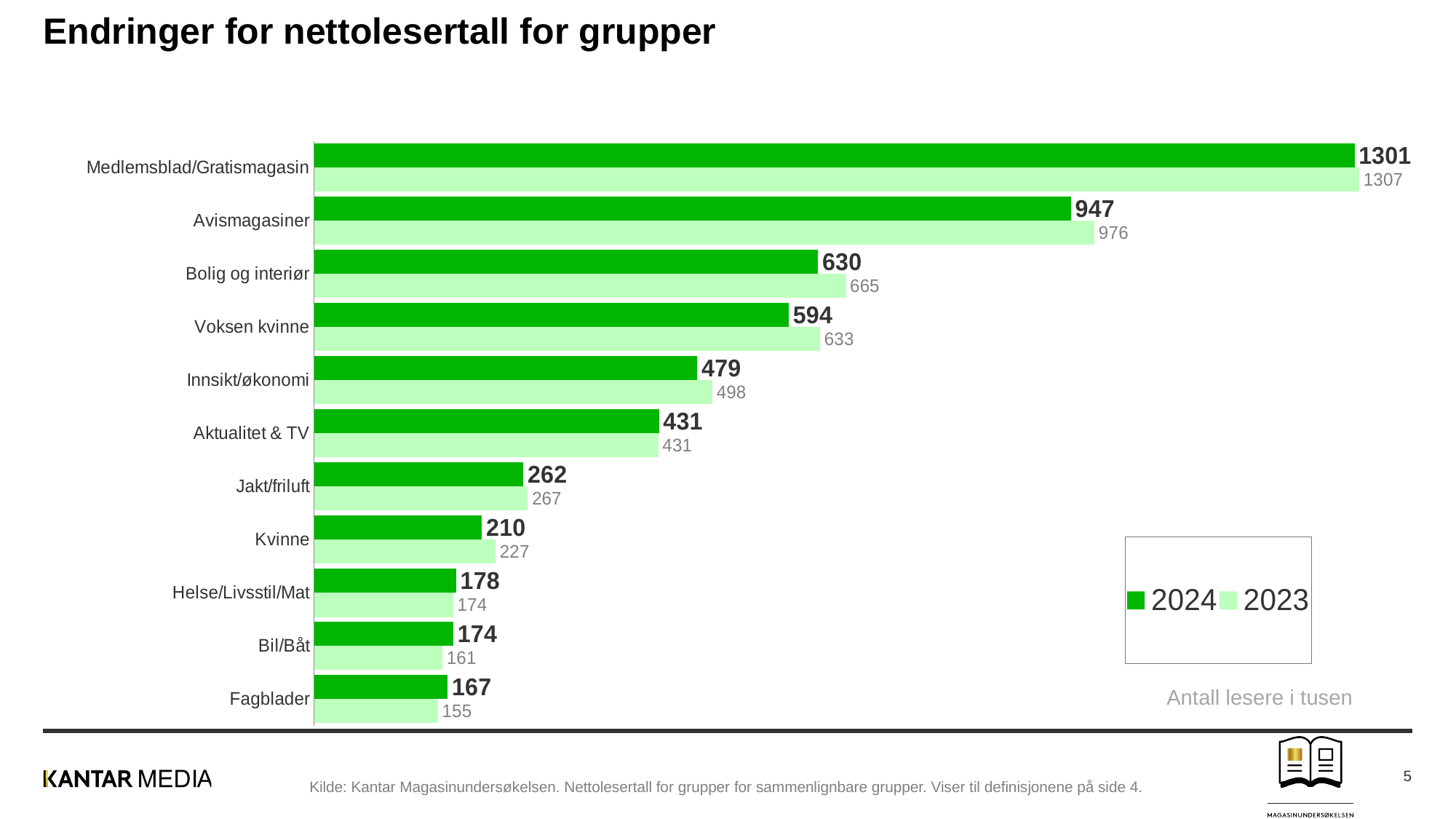
How many series does the legend list? 2 What is the 2023 value for Voksen kvinne? 633 What is the difference between the 2024 values for Avismagasiner and Bolig og interiør? 317 What is the difference between the 2023 and 2024 values for Bolig og interiør? 35 What kind of chart is shown on the slide? Bar chart What is the title of the chart on the slide? Endringer for nettolesertall for grupper What is the 2024 value for Avismagasiner? 947 Which category has the lowest 2023 value? Fagblader What is the 2024 value for Fagblader? 167 Which is larger for Bil/Båt, the 2024 value or the 2023 value? 2024 Which category has the highest 2024 value? Medlemsblad/Gratismagasin How many categories are shown in the chart? 11